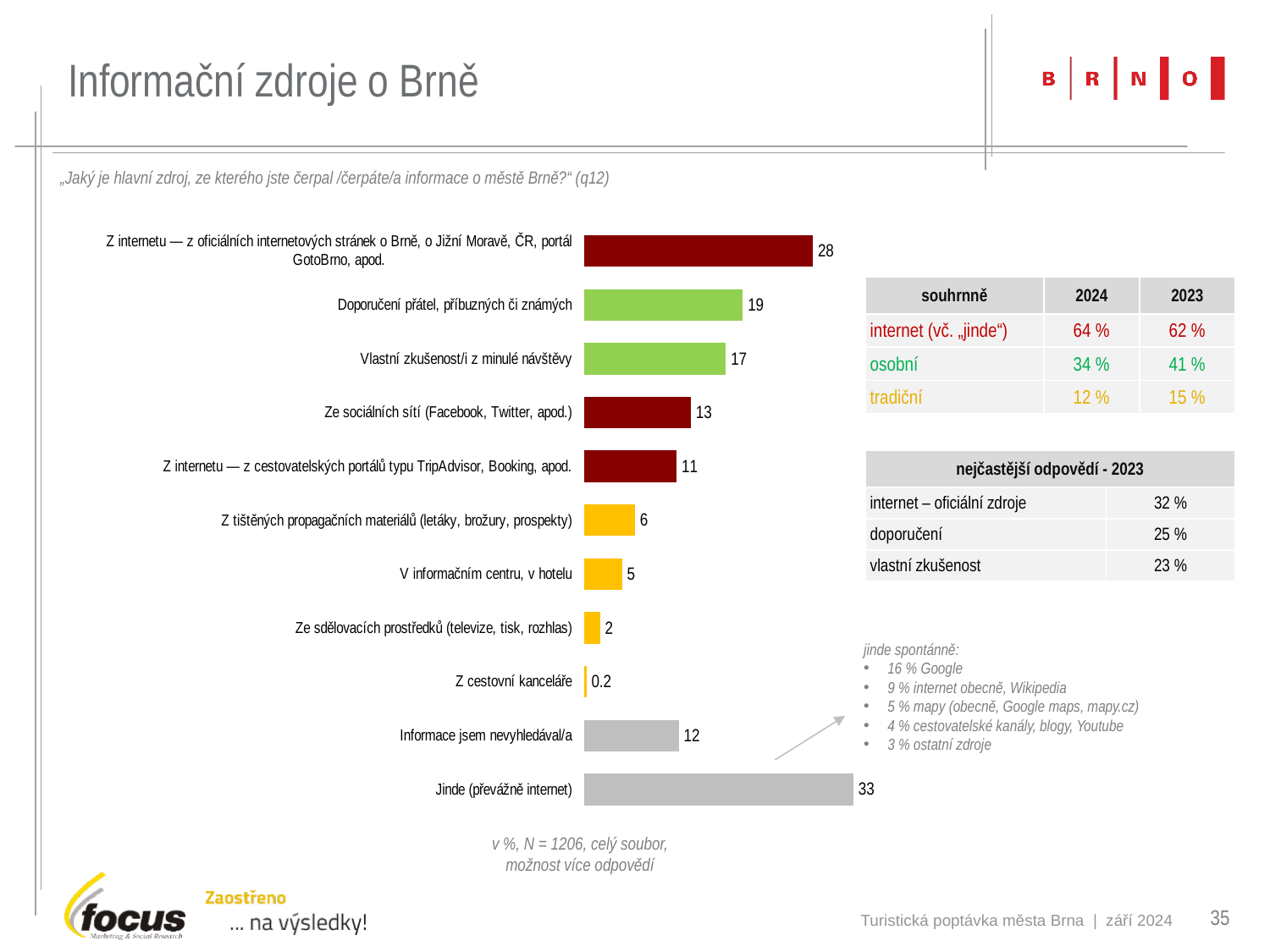
What value is shown for "Z cestovní kanceláře"? 0.2 What is the difference between the values for "Vlastní zkušenost/i z minulé návštěvy" and "Z tištěných propagačních materiálů (letáky, brožury, prospekty)"? 11 What kind of chart is shown on the slide? bar chart Which category has the lowest value in the chart? Z cestovní kanceláře What value is shown for "Ze sociálních sítí (Facebook, Twitter, apod.)"? 13 How many categories are shown in the bar chart? 11 What value is shown for "Informace jsem nevyhledával/a"? 12 Which is larger: the value for "Z internetu — z cestovatelských portálů typu TripAdvisor, Booking, apod." or the value for "V informačním centru, v hotelu"? Z internetu — z cestovatelských portálů typu TripAdvisor, Booking, apod. What value is shown for "Doporučení přátel, příbuzných či známých"? 19 Which category has the highest value in the chart? Jinde (převážně internet) What is the difference between the values for "Jinde (převážně internet)" and "Z internetu — z oficiálních internetových stránek o Brně, o Jižní Moravě, ČR, portál GotoBrno, apod."? 5 What is the title of the slide containing the chart? Informační zdroje o Brně